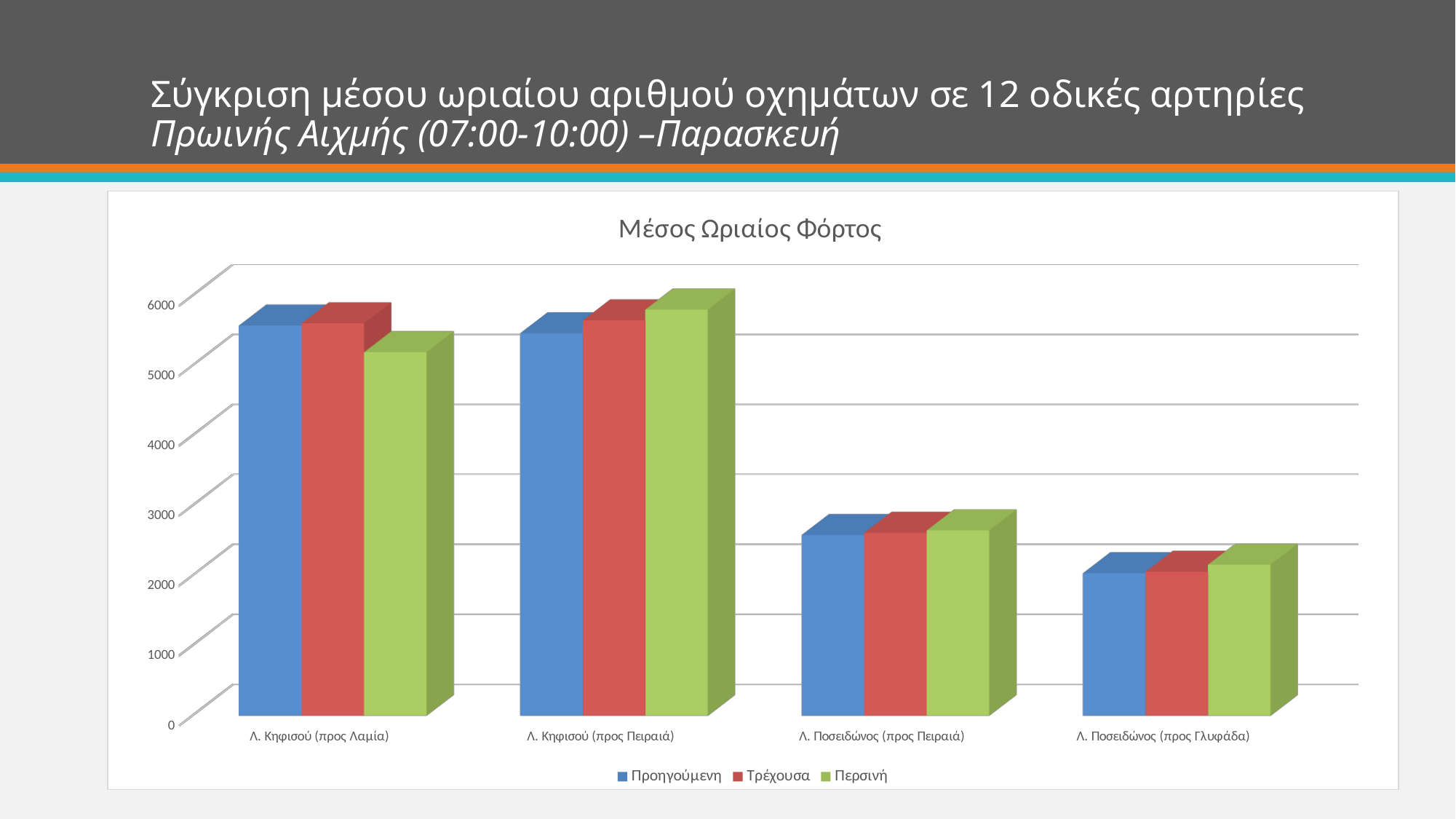
Which series is shown in red in the legend? Τρέχουσα Which category has the lowest values across all three series? Λ. Ποσειδώνος (προς Γλυφάδα) Is the Προηγούμενη value for Λ. Κηφισού (προς Λαμία) greater or less than 5000? greater What is the title of the chart? Μέσος Ωριαίος Φόρτος For the Προηγούμενη series, which is larger: Λ. Κηφισού (προς Λαμία) or Λ. Ποσειδώνος (προς Πειραιά)? Λ. Κηφισού (προς Λαμία) What type of chart is shown on the slide? Bar chart How many series does the legend list? 3 How many road categories are shown on the x axis? 4 Is the Περσινή value for Λ. Κηφισού (προς Πειραιά) greater or less than 5000? greater Is the Περσινή value for Λ. Ποσειδώνος (προς Γλυφάδα) greater or less than 3000? less For the Τρέχουσα series, which is larger: Λ. Κηφισού (προς Πειραιά) or Λ. Ποσειδώνος (προς Γλυφάδα)? Λ. Κηφισού (προς Πειραιά)